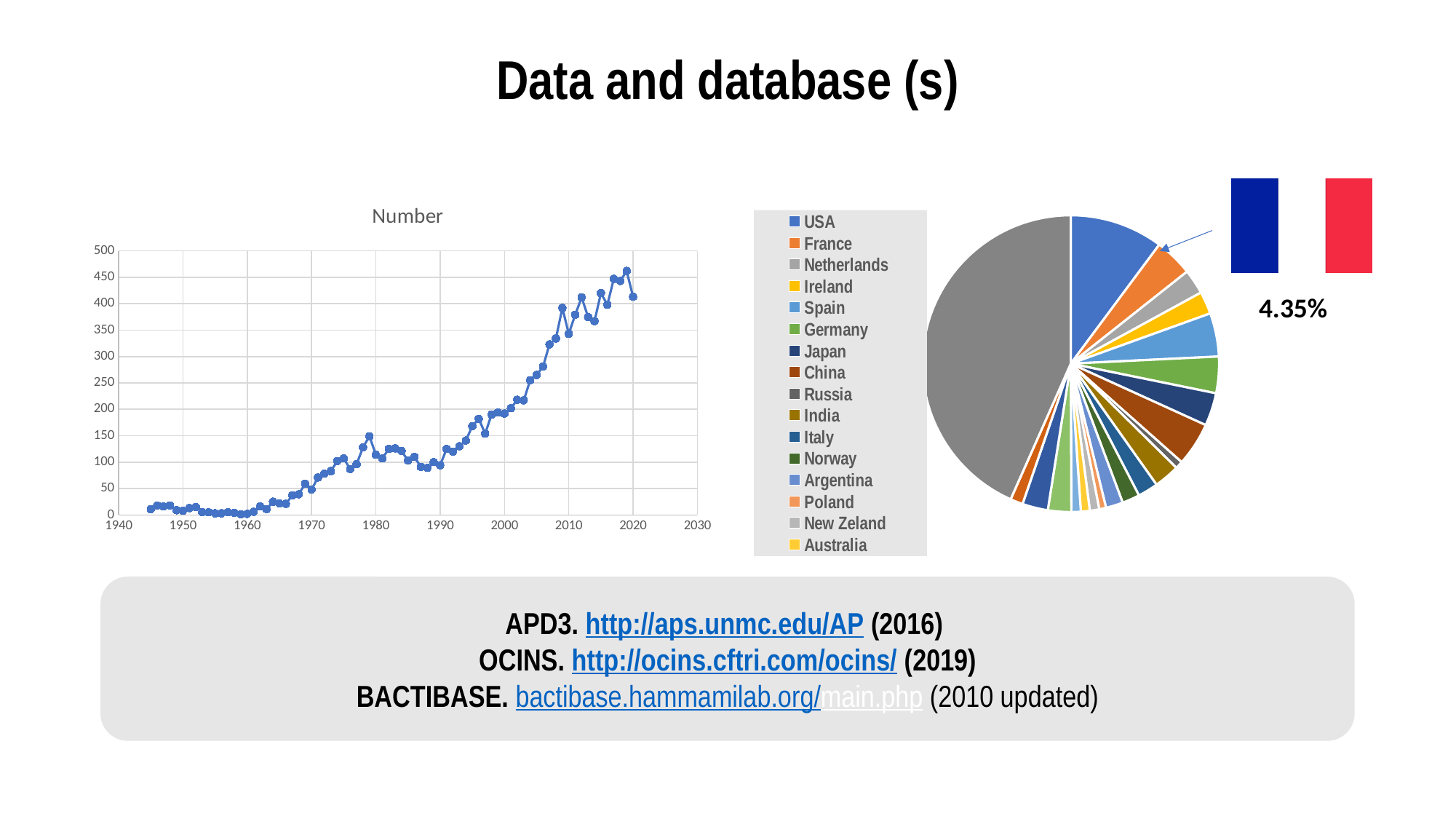
What is the title of the line chart on the left? Number In the pie chart, which slice is larger, USA or France? USA In the "Number" line chart, is the value around 2009 greater or less than 350? greater In the pie chart legend, what colour represents France? orange In the "Number" line chart, is the value around 2019 greater or less than 400? greater How many entries does the legend of the pie chart list? 16 In the pie chart, what share is labelled for the France slice? 4.35% In the "Number" line chart, is the value around 1990 greater or less than 150? less In the "Number" line chart, do the values generally rise or fall from 1940 to 2020? rise What kind of chart is the chart on the left titled "Number"? line chart What kind of chart is the chart on the right of the slide? pie chart